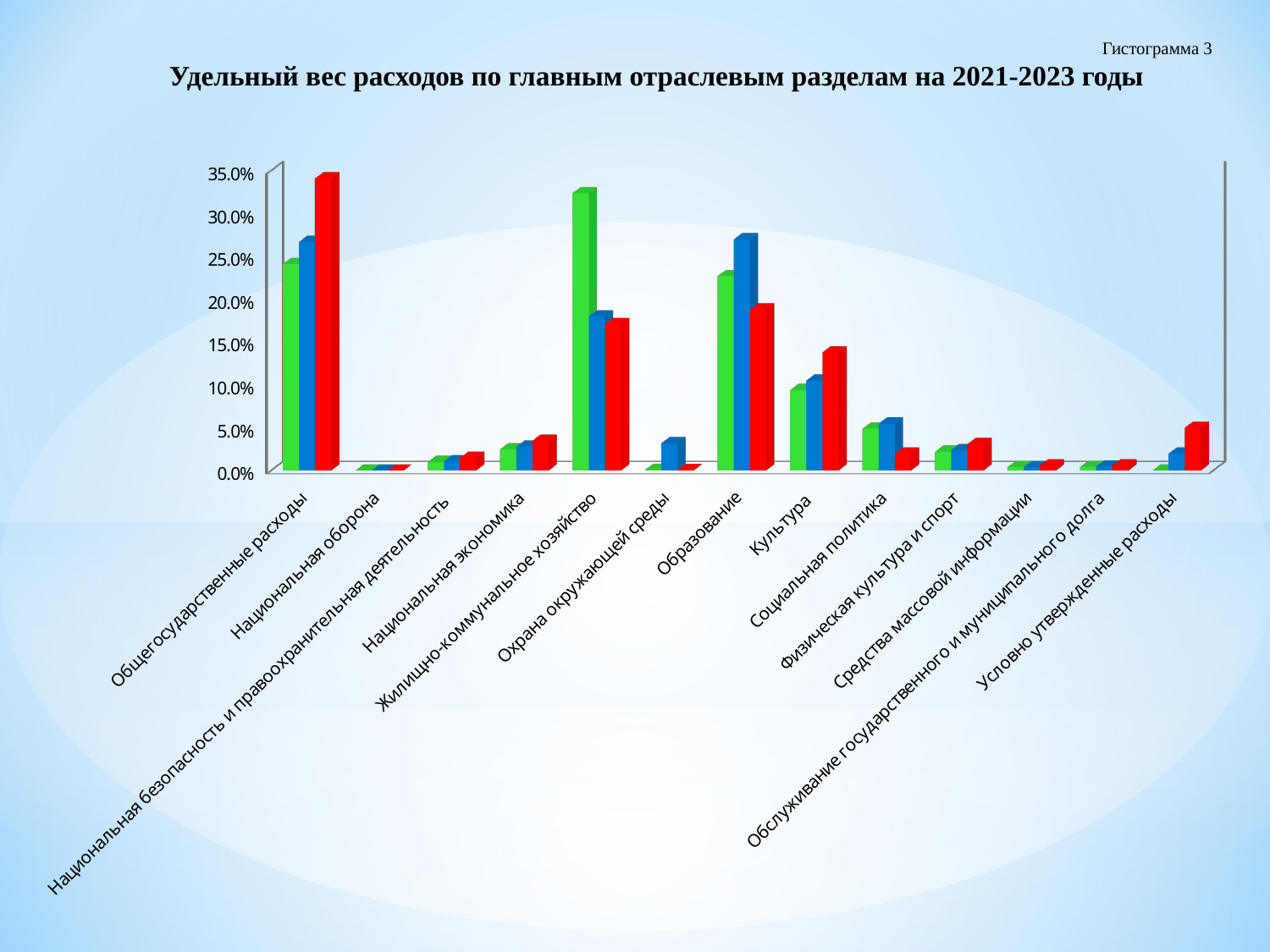
Which category has the tallest green bar? Жилищно-коммунальное хозяйство How many bars are plotted for each category in the chart? 3 Is the green bar for Образование greater or less than 20.0%? greater For Общегосударственные расходы, which is larger: the green bar or the red bar? The red bar Is the green bar for Жилищно-коммунальное хозяйство greater or less than 30.0%? greater Which category has the tallest red bar? Общегосударственные расходы Is the red bar for Условно утвержденные расходы greater or less than 10.0%? less What kind of chart is shown on the slide? Bar chart What is the title of the chart? Удельный вес расходов по главным отраслевым разделам на 2021-2023 годы How many categories are shown on the x axis of the chart? 13 For Жилищно-коммунальное хозяйство, which is larger: the green bar or the red bar? The green bar